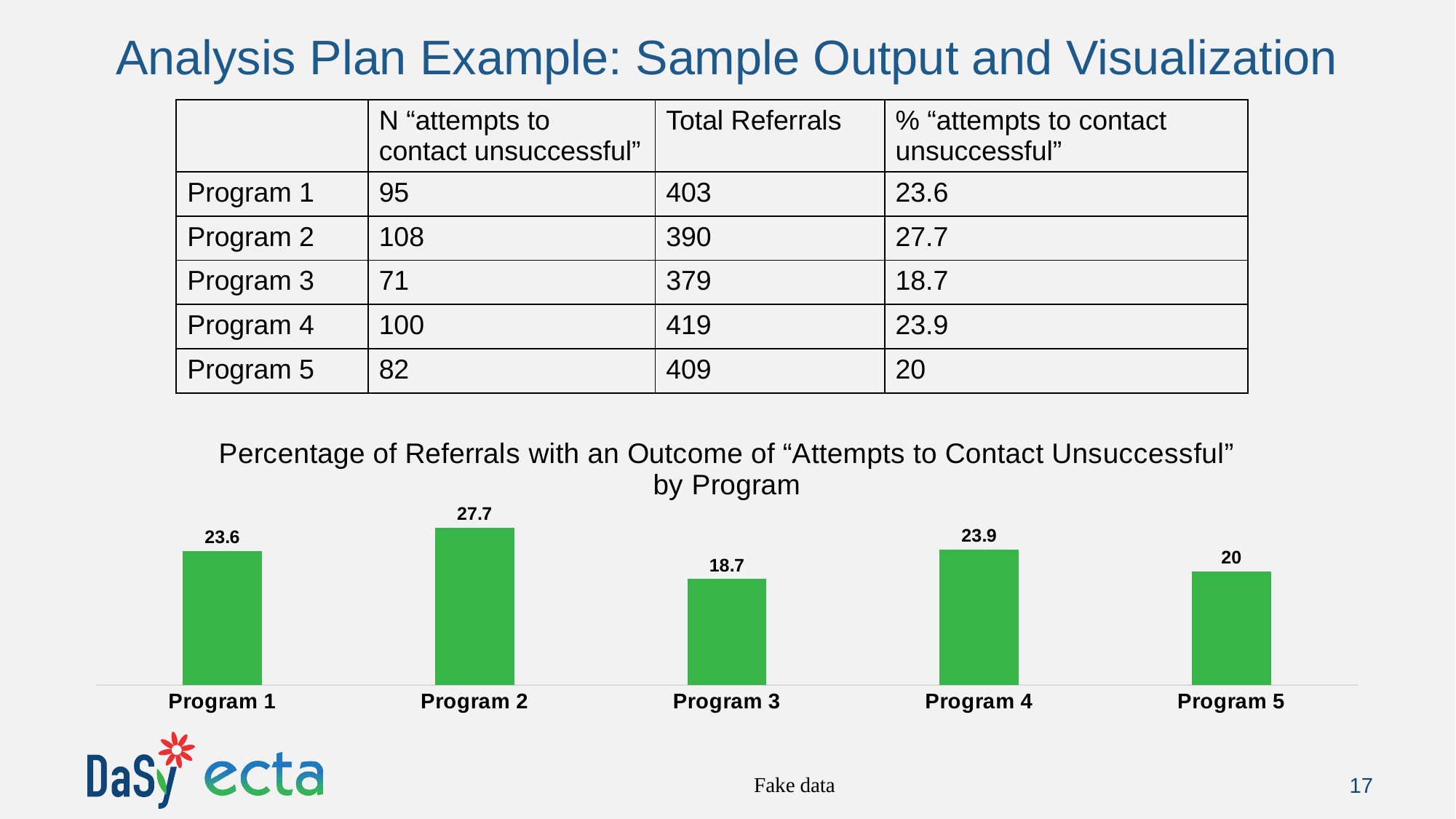
What is the difference between the values for Program 4 and Program 1 in the bar chart? 0.3 Which program has the lowest percentage in the bar chart? Program 3 Which program has the highest percentage in the bar chart? Program 2 Which is larger in the bar chart, the value for Program 1 or the value for Program 5? Program 1 What is the value for Program 5 in the bar chart? 20 What is the value for Program 3 in the bar chart? 18.7 What is the difference between the values for Program 2 and Program 3 in the bar chart? 9 What is the title of the chart on the slide? Percentage of Referrals with an Outcome of "Attempts to Contact Unsuccessful" by Program What is the value for Program 2 in the bar chart? 27.7 What kind of chart is shown on the slide? Bar chart What colour are the bars in the chart? Green How many programs are shown in the bar chart? 5